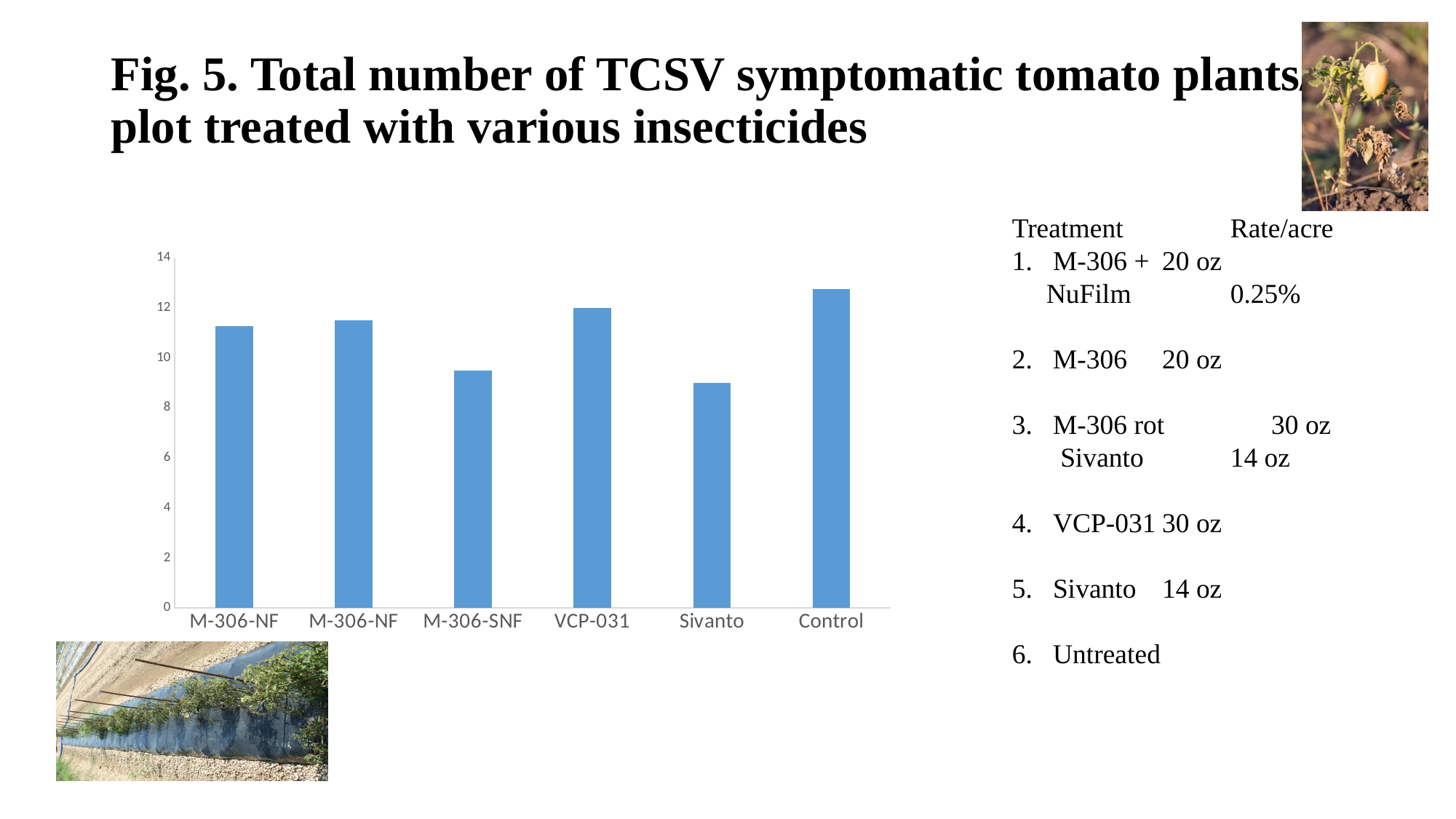
Is the value for Control greater or less than 12? greater Which has a higher value in the chart, VCP-031 or M-306-SNF? VCP-031 What is the maximum value shown on the y axis of the chart? 14 Is the value for VCP-031 greater or less than 10? greater How many treatment categories are shown on the x axis of the chart? 6 Which treatment has the lowest number of TCSV symptomatic plants in the chart? Sivanto Which treatment has the highest number of TCSV symptomatic plants in the chart? Control What kind of chart is shown on the slide? bar chart Is the value for Sivanto greater or less than 10? less Which has a higher value in the chart, Control or Sivanto? Control What colour are the bars in the chart? blue